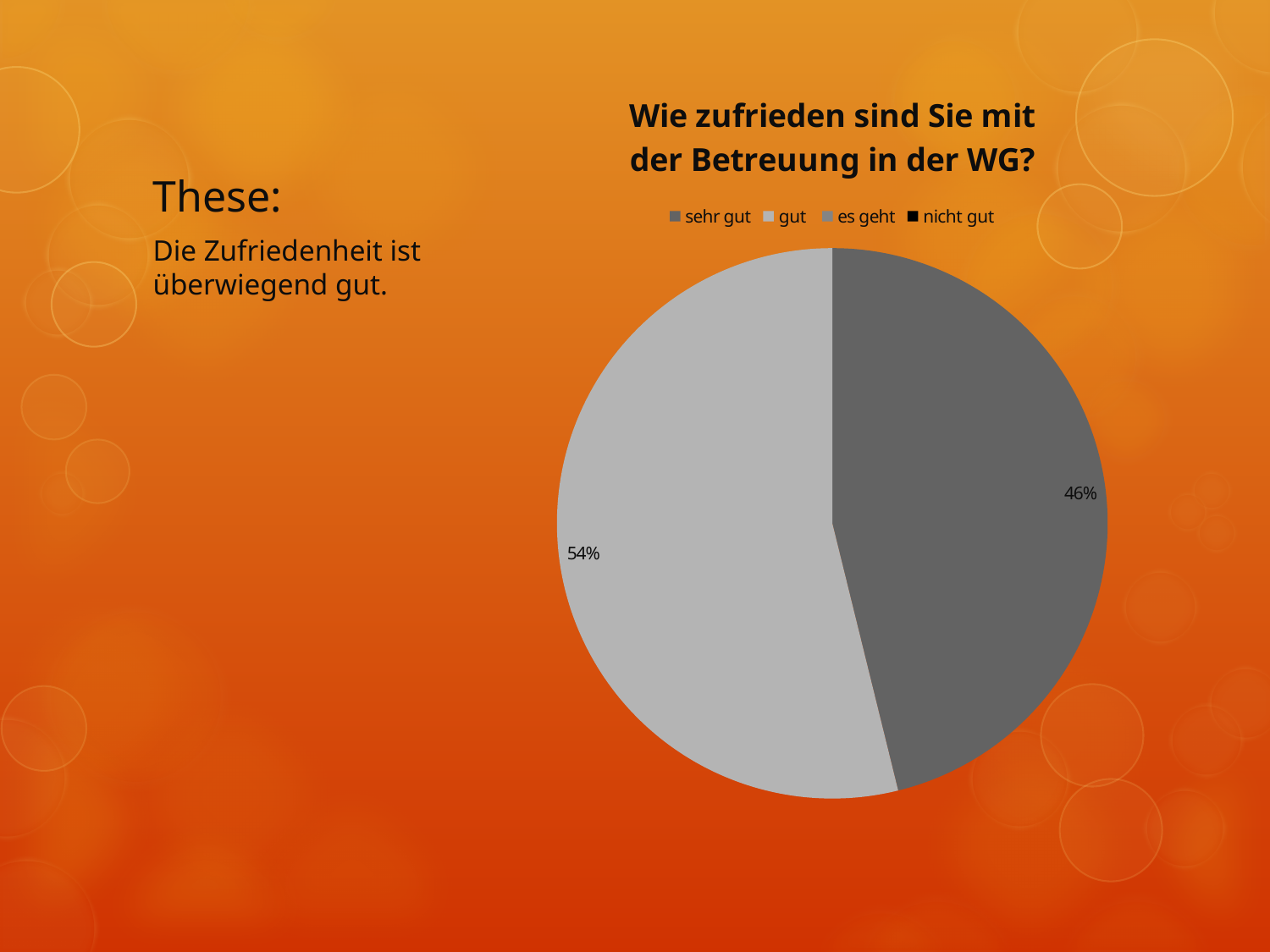
What type of chart is shown on the slide? pie chart What share of the pie does "gut" represent? 54% Which legend entry corresponds to the dark grey slice? sehr gut What is the title of the chart? Wie zufrieden sind Sie mit der Betreuung in der WG? How many slices are visible in the pie chart? 2 What do the two labelled slices add up to? 100% How many entries does the chart legend list? 4 Is the slice for "gut" larger or smaller than the slice for "sehr gut"? larger Which of the two visible slices is smaller, "sehr gut" or "gut"? sehr gut Which category has the largest slice of the pie? gut By how many percentage points does "gut" exceed "sehr gut"? 8 percentage points What share of the pie does "sehr gut" represent? 46%